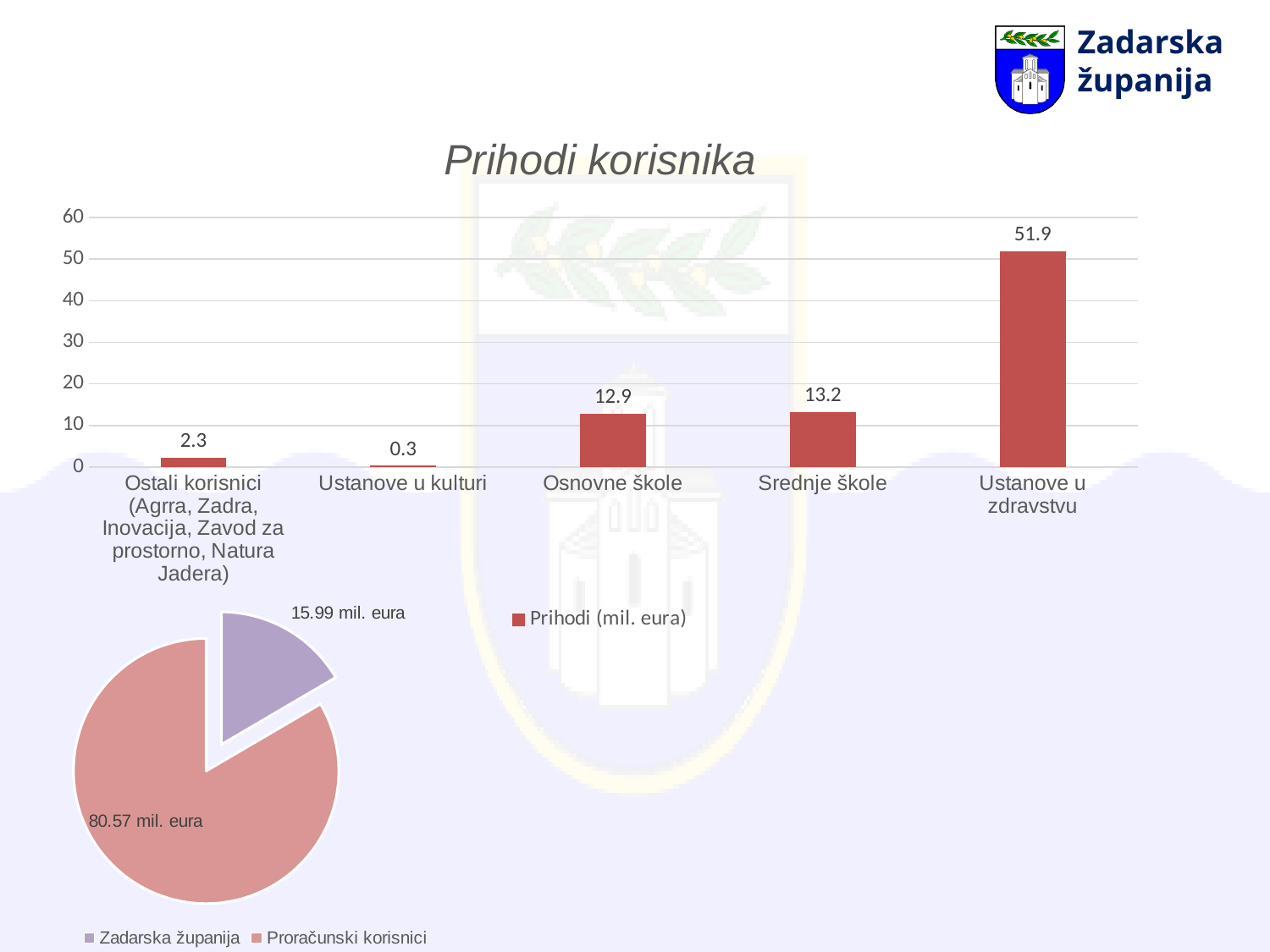
In the bar chart 'Prihodi korisnika', how many categories are shown on the x axis? 5 In the bar chart 'Prihodi korisnika', what is the difference between the values for Srednje škole and Osnovne škole? 0.3 In the bar chart 'Prihodi korisnika', what is the value for Osnovne škole? 12.9 In the bar chart 'Prihodi korisnika', which category has the highest value? Ustanove u zdravstvu In the bar chart 'Prihodi korisnika', what is the value for Ustanove u kulturi? 0.3 In the pie chart at the bottom left, what is the value for Zadarska županija? 15.99 mil. eura In the bar chart 'Prihodi korisnika', what is the legend entry for the series? Prihodi (mil. eura) In the pie chart at the bottom left, which slice is larger: Zadarska županija or Proračunski korisnici? Proračunski korisnici In the bar chart 'Prihodi korisnika', which category has the lowest value? Ustanove u kulturi In the bar chart 'Prihodi korisnika', which is larger: the value for Srednje škole or for Osnovne škole? Srednje škole What kind of chart is the chart at the bottom left of the slide? Pie chart In the bar chart 'Prihodi korisnika', what is the value for Ustanove u zdravstvu? 51.9